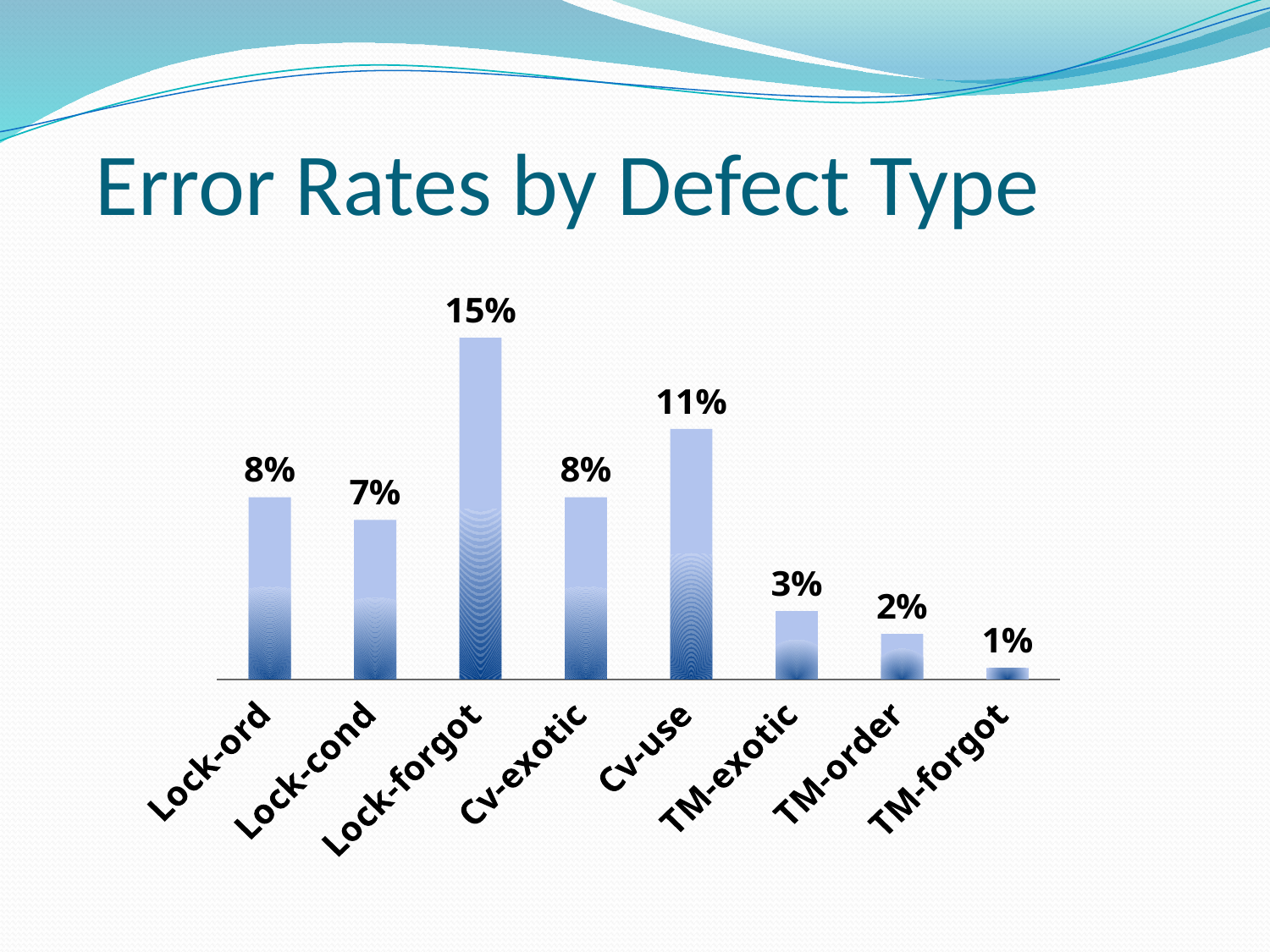
What is the difference between the error rates for Lock-ord and TM-exotic? 5% What is the error rate for Lock-cond? 7% What kind of chart is shown on the slide? Bar chart What is the error rate for Cv-use? 11% What is the error rate for Lock-forgot? 15% Which defect type has the highest error rate? Lock-forgot Which defect type has the lowest error rate? TM-forgot What is the title of the slide? Error Rates by Defect Type What is the difference between the error rates for Lock-forgot and Cv-use? 4% Which has a higher error rate, Cv-use or Cv-exotic? Cv-use What is the error rate for TM-order? 2% How many defect types are shown in the chart? 8